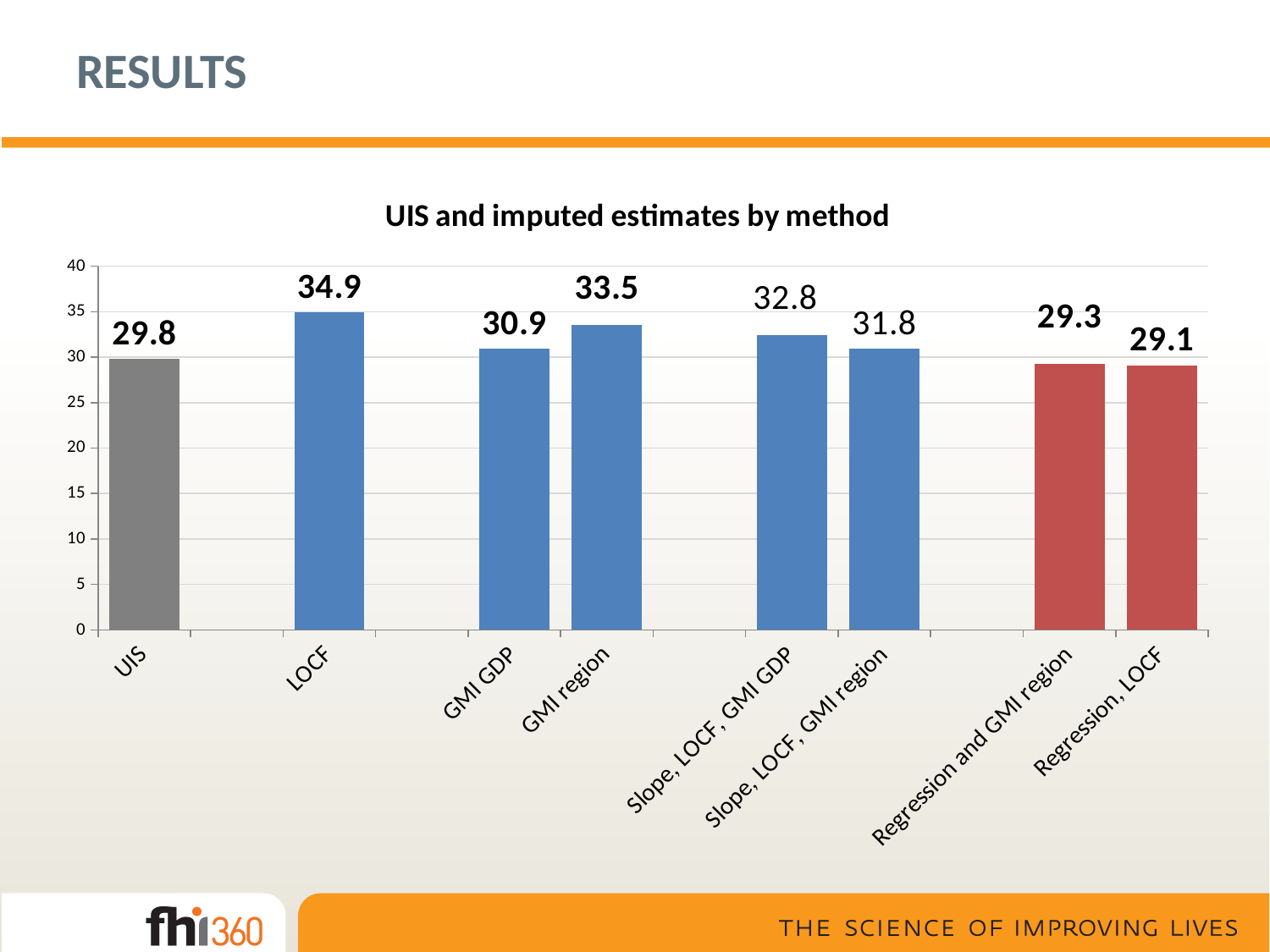
How many bars are shown in the chart? 8 What kind of chart is shown on the slide? Bar chart Which is larger, the value for GMI GDP or the value for GMI region? GMI region Which method has the highest value? LOCF What is the value for LOCF? 34.9 What is the value for UIS? 29.8 What is the value for Slope, LOCF, GMI GDP? 32.8 What is the value for Regression, LOCF? 29.1 What is the difference between the LOCF value and the UIS value? 5.1 What is the title of the chart? UIS and imputed estimates by method Which method has the lowest value? Regression, LOCF What is the value for GMI region? 33.5